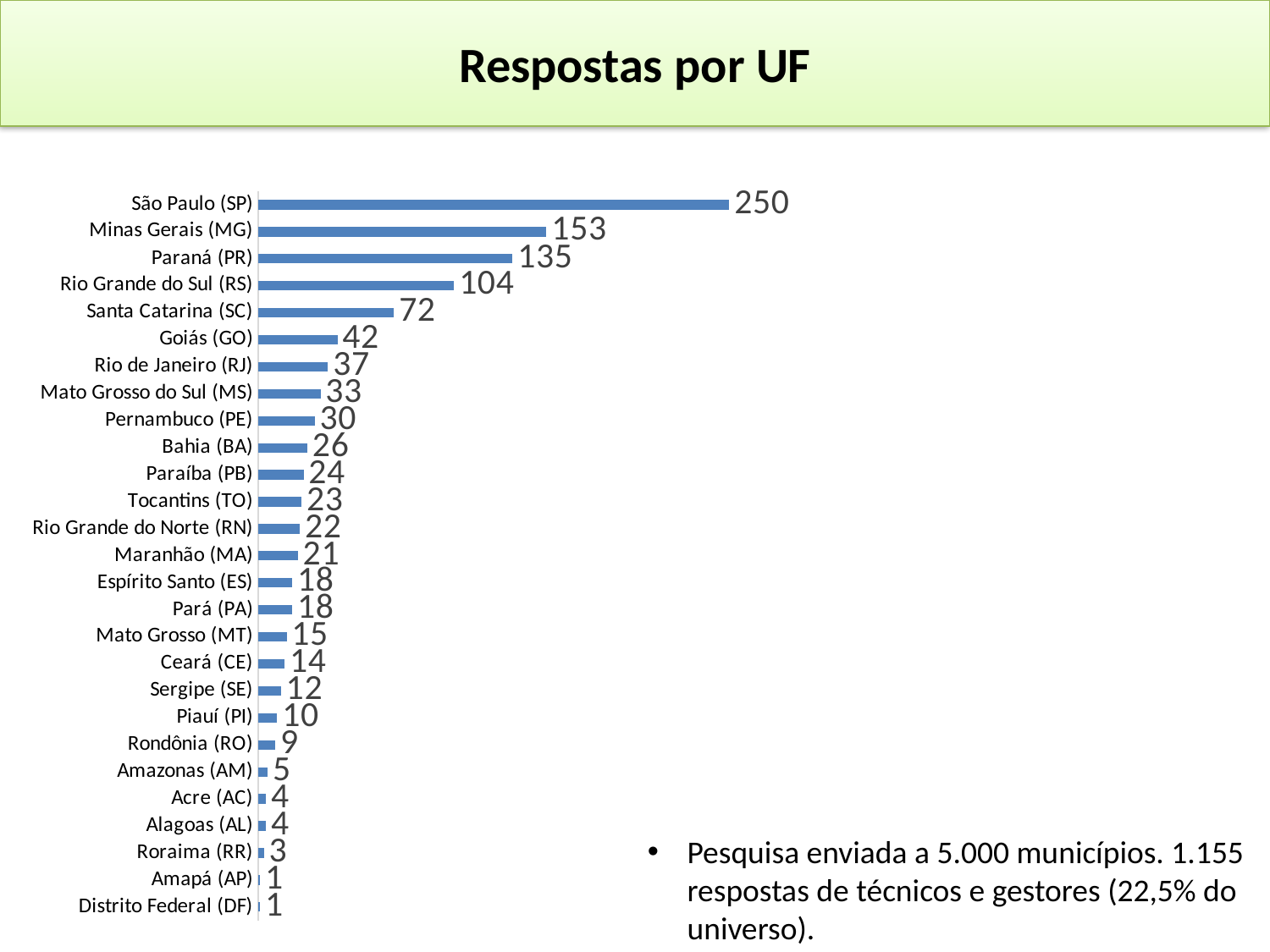
How many states (categories) are shown in the chart? 27 Which state has the highest number of responses? São Paulo (SP) What is the lowest value shown in the chart? 1 What is the value for Pernambuco (PE)? 30 What is the value for Rio Grande do Sul (RS)? 104 What is the value for São Paulo (SP)? 250 What type of chart is shown on the slide? bar chart What is the difference between the values for São Paulo (SP) and Minas Gerais (MG)? 97 Which has a larger value, Goiás (GO) or Rio de Janeiro (RJ)? Goiás (GO) What is the title of the slide? Respostas por UF What is the difference between the values for Paraná (PR) and Santa Catarina (SC)? 63 What is the value for Rondônia (RO)? 9